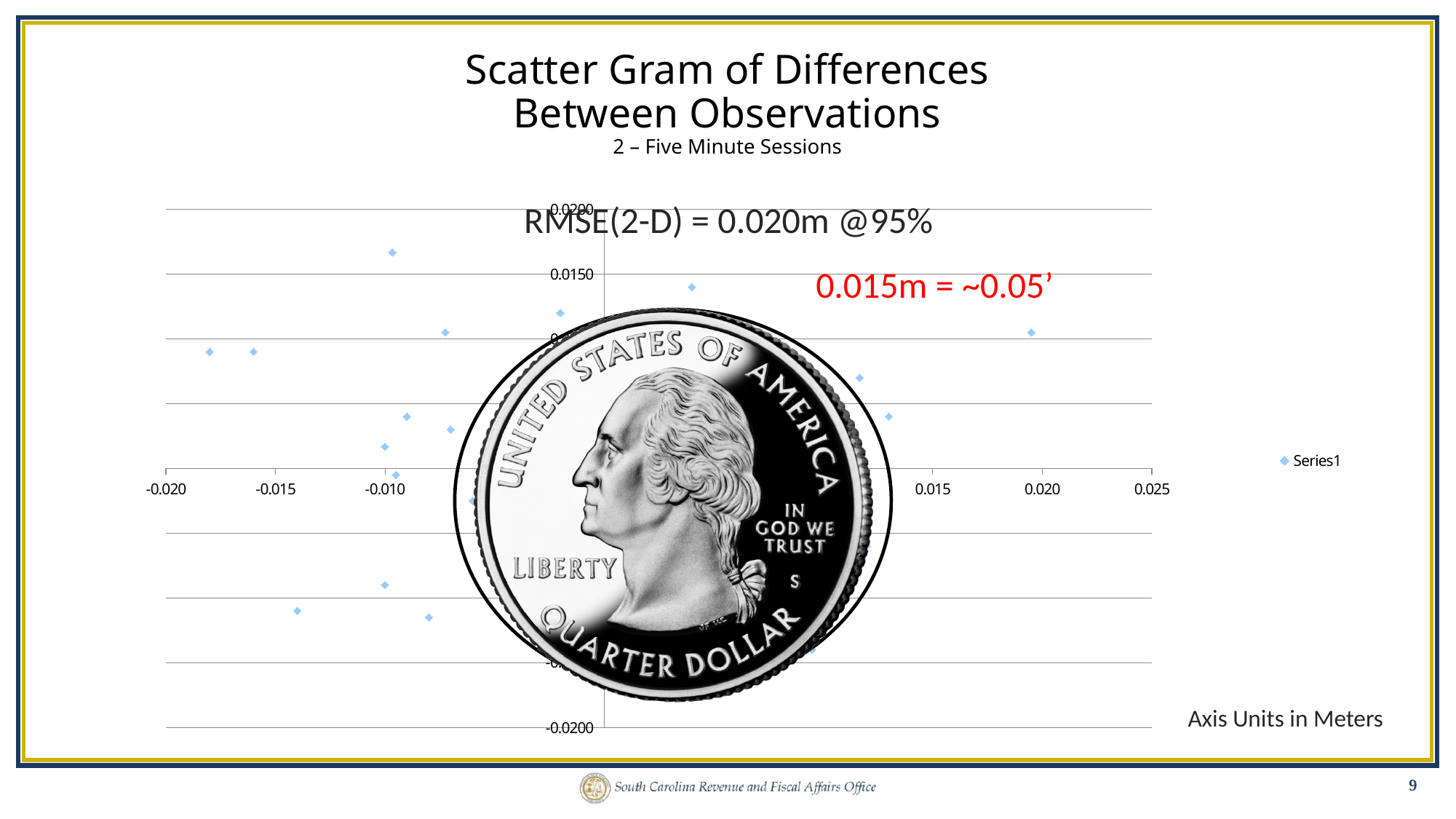
Is the y value of the highest plotted point greater or less than 0.0150? greater What units are the chart axes in, according to the slide? Meters What RMSE(2-D) value is stated on the chart? 0.020m @95% What is the lowest value labelled on the y axis? -0.0200 How many series does the chart legend list? 1 Is the x value of the leftmost plotted point greater or less than -0.015? less What is the largest value labelled on the x axis? 0.025 What kind of chart is shown on the slide? scatter chart What is the name of the series shown in the chart legend? Series1